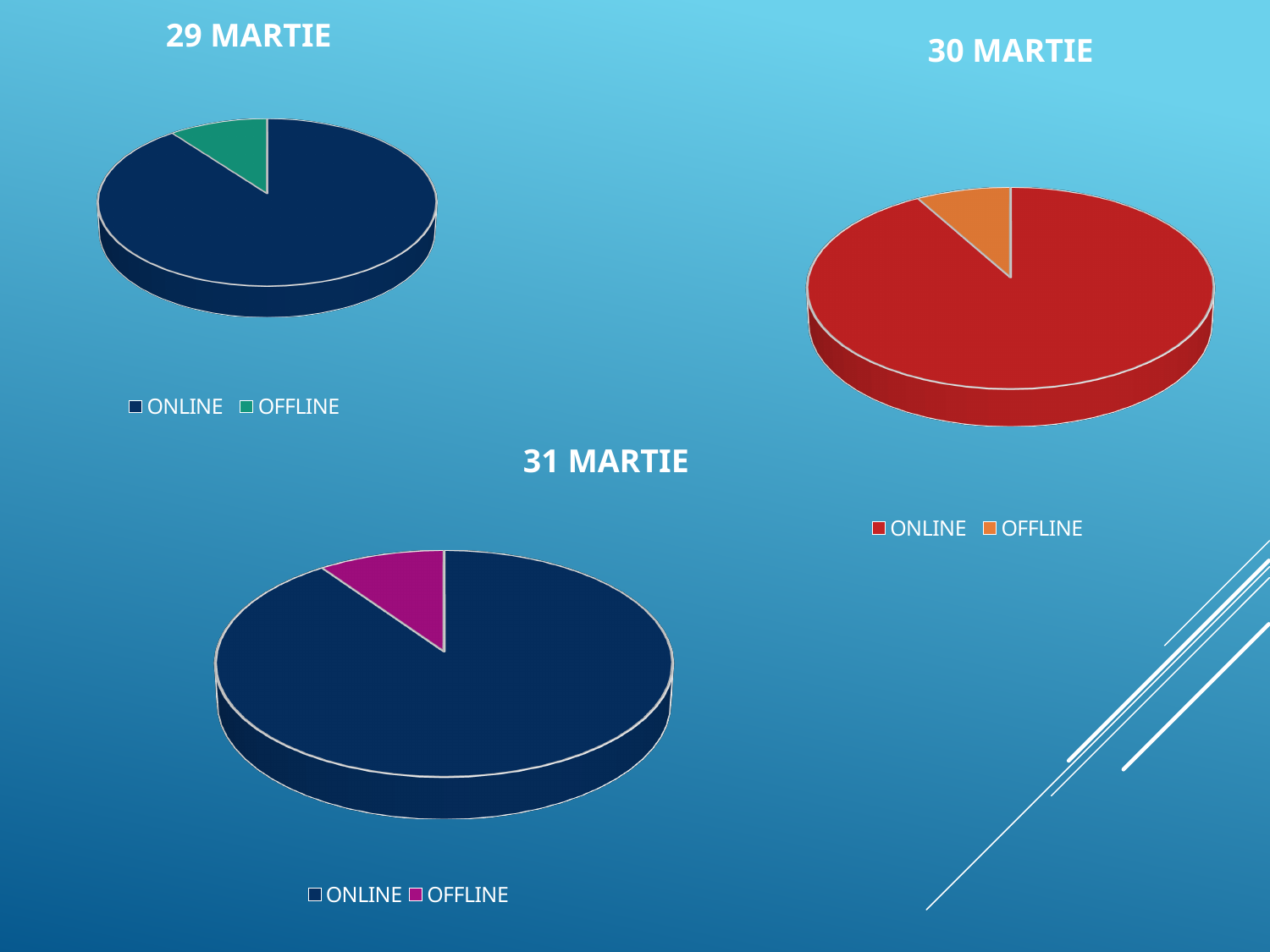
What colour is the OFFLINE slice in the "31 MARTIE" chart? magenta In the "29 MARTIE" chart, which category has the smallest slice? OFFLINE How many entries does the legend of the "30 MARTIE" chart list? 2 In the "31 MARTIE" chart, which category has the smallest slice? OFFLINE What colour is the ONLINE slice in the "30 MARTIE" chart? red What kind of chart is the "29 MARTIE" chart? pie chart How many pie charts are shown on the slide? 3 How many slices does the "29 MARTIE" pie chart have? 2 In the "30 MARTIE" chart, which is larger, ONLINE or OFFLINE? ONLINE In the "30 MARTIE" chart, which category has the largest slice? ONLINE What kind of chart is the "31 MARTIE" chart? pie chart In the "29 MARTIE" chart, which category has the largest slice? ONLINE